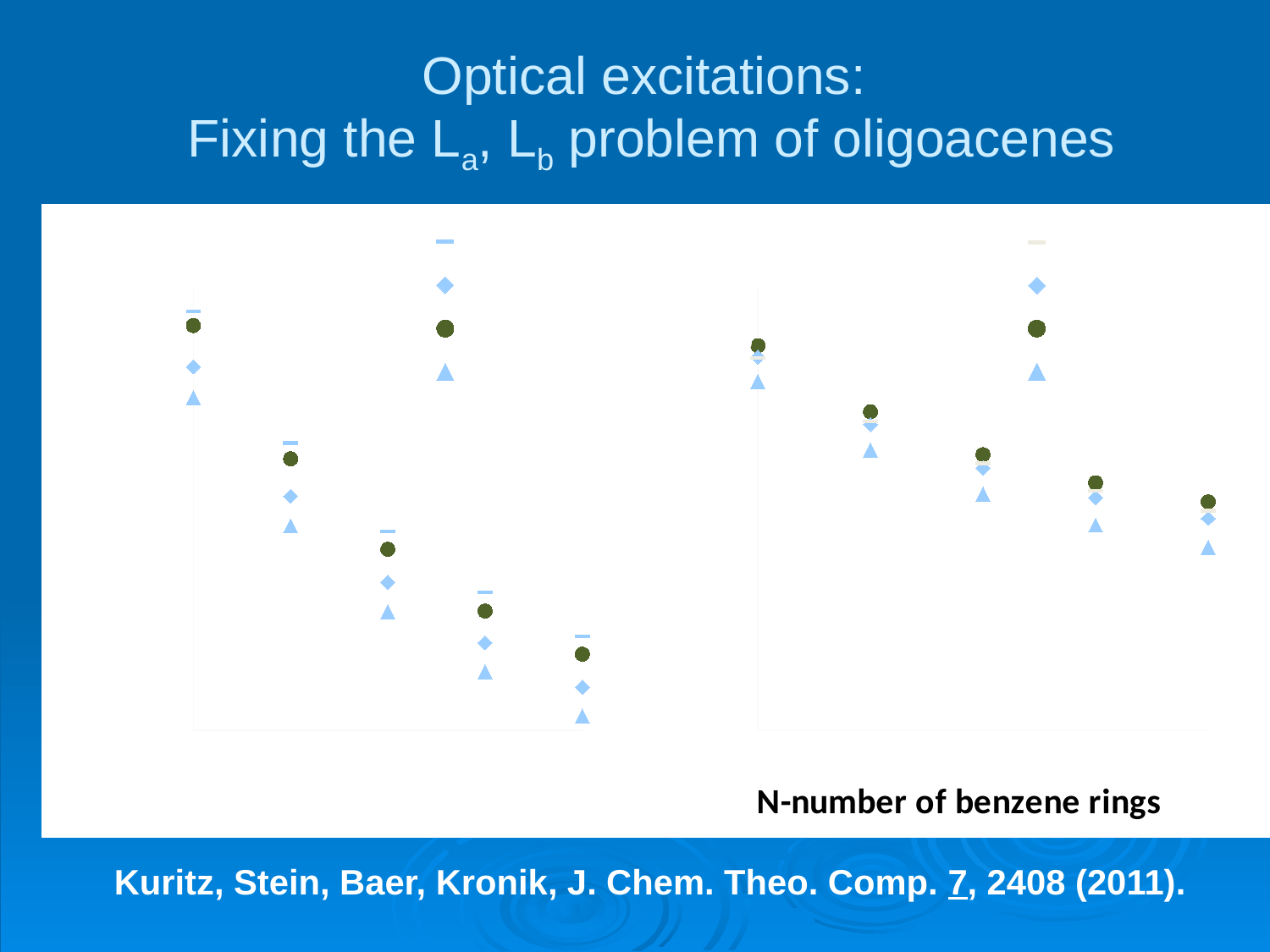
How many charts are shown on the slide? 2 In the left chart, is the green circle at the leftmost x position higher or lower than the green circle at the rightmost x position? higher In the right chart, do the plotted values rise or fall as you move along the x axis? fall What kind of chart is shown on the left of the slide? scatter chart What kind of chart is shown on the right of the slide? scatter chart In the right chart, is the green circle at the leftmost x position higher or lower than the green circle at the rightmost x position? higher What quantity does the x axis of the charts represent, according to the label on the slide? N-number of benzene rings In the left chart, do the plotted values rise or fall as you move along the x axis? fall